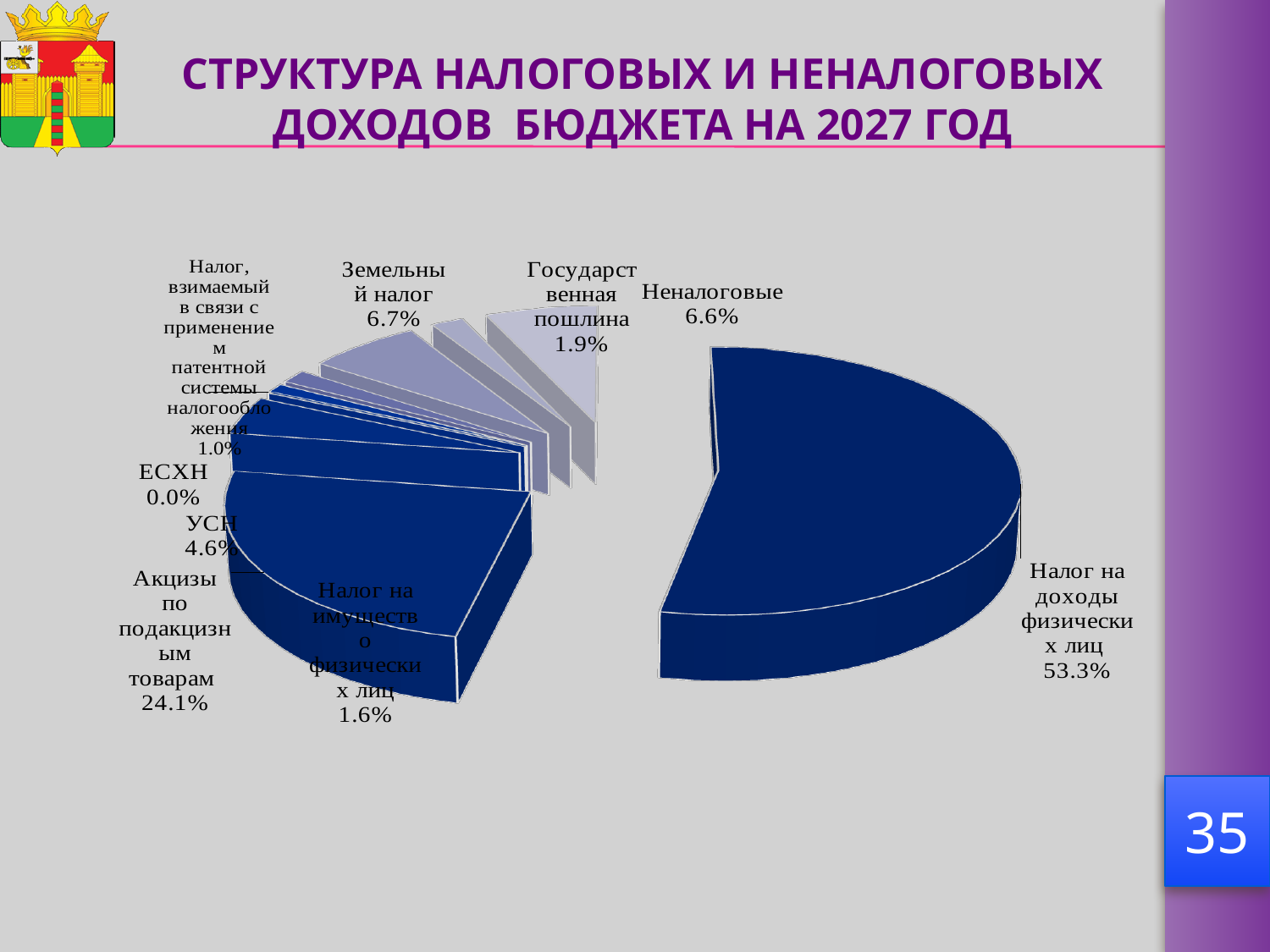
What is the value shown for "Акцизы по подакцизным товарам"? 24.1% What is the value for "Неналоговые" revenues? 6.6% Which is larger: the share of "УСН" or the share of "Налог на имущество физических лиц"? УСН What year does the chart title refer to? 2027 What is the difference between the shares of "Налог на доходы физических лиц" and "Акцизы по подакцизным товарам"? 29.2% What percentage is shown for "Земельный налог"? 6.7% What percentage is shown for "Государственная пошлина"? 1.9% Which category has the largest share of the pie? Налог на доходы физических лиц What share of the budget revenue does "Налог на доходы физических лиц" account for? 53.3% What kind of chart is shown on the slide? Pie chart Which category has the smallest share of the pie? ЕСХН How many categories are shown in the pie chart? 9